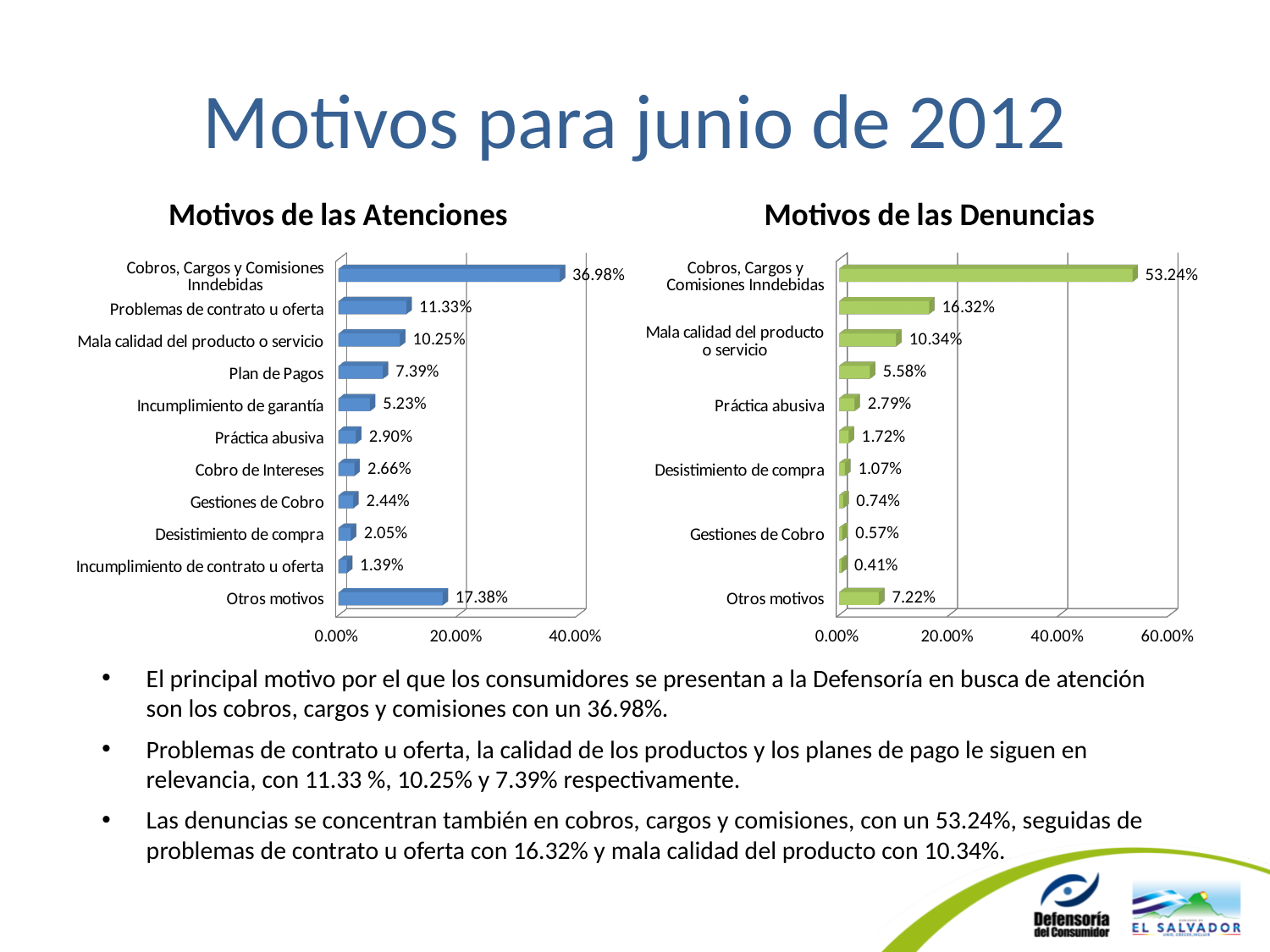
In the 'Motivos de las Atenciones' chart, which category has the lowest value? Incumplimiento de contrato u oferta In the 'Motivos de las Denuncias' chart, what is the value for Mala calidad del producto o servicio? 10.34% In the 'Motivos de las Atenciones' chart, what is the difference between Problemas de contrato u oferta and Mala calidad del producto o servicio? 1.08% In the 'Motivos de las Denuncias' chart, what is the difference between Cobros, Cargos y Comisiones Inndebidas and Otros motivos? 46.02% In the 'Motivos de las Denuncias' chart, which labeled category has the highest value? Cobros, Cargos y Comisiones Inndebidas In the 'Motivos de las Denuncias' chart, what is the value for Otros motivos? 7.22% In the 'Motivos de las Atenciones' chart, what is the value for Plan de Pagos? 7.39% In the 'Motivos de las Atenciones' chart, which is larger: Otros motivos or Problemas de contrato u oferta? Otros motivos How many bars does the 'Motivos de las Atenciones' chart show? 11 What type of chart is 'Motivos de las Denuncias'? Bar chart In the 'Motivos de las Atenciones' chart, what is the value for Cobros, Cargos y Comisiones Inndebidas? 36.98% What colour are the bars in the 'Motivos de las Denuncias' chart? Green